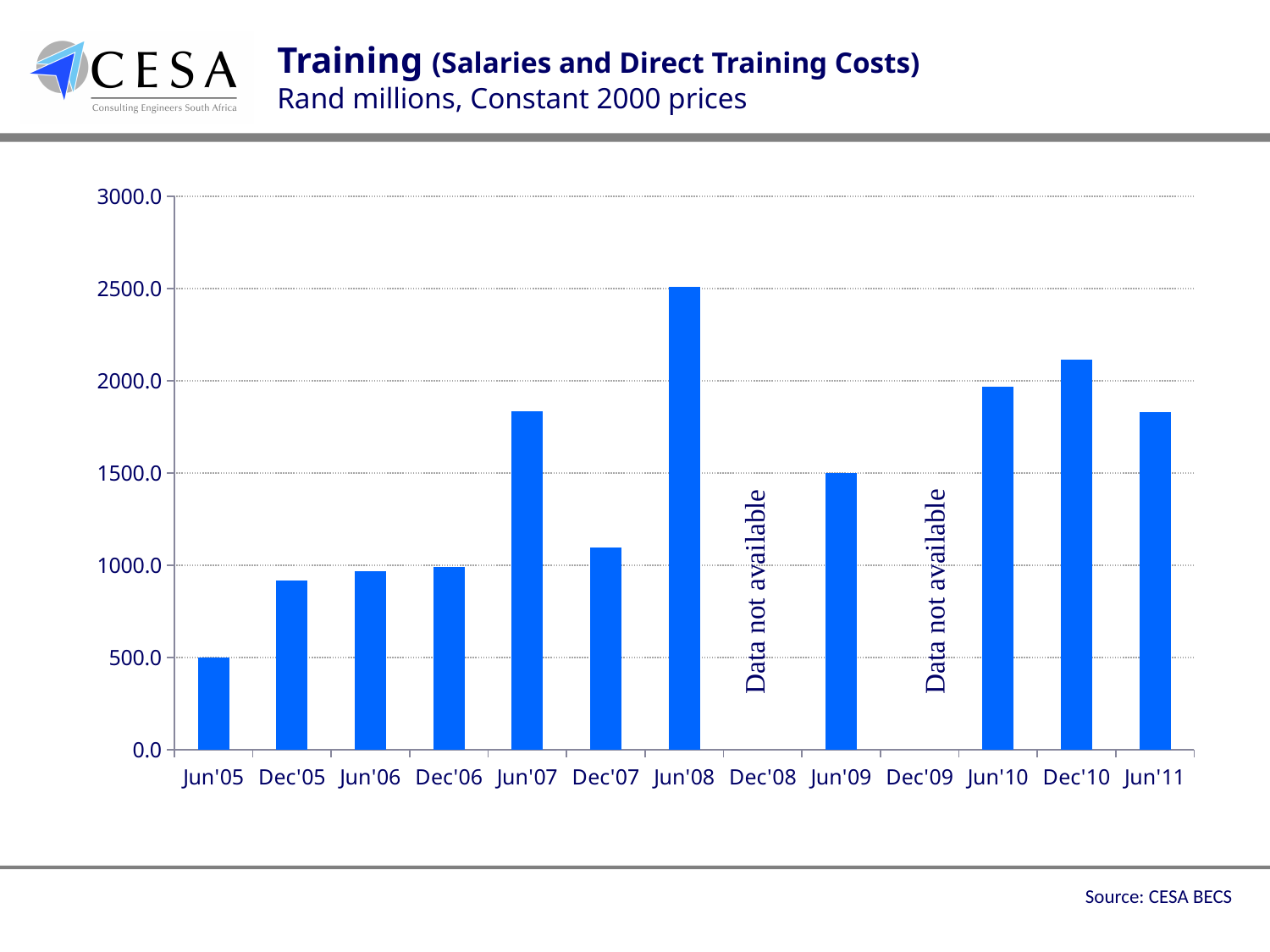
Which periods are marked 'Data not available'? Dec'08 and Dec'09 Is the value for Dec'05 greater or less than 1000.0? less How many periods have a bar plotted (data available)? 11 Is the value for Dec'10 greater or less than 2000.0? greater Which period has the highest training value? Jun'08 Is the value for Dec'07 greater or less than 1000.0? greater How many periods are labelled on the x axis? 13 In what units are the values on the chart expressed? Rand millions, Constant 2000 prices What kind of chart is shown on the slide? bar chart Which period has the lowest training value among those with a bar? Jun'05 Which is larger, the value for Jun'07 or the value for Dec'07? Jun'07